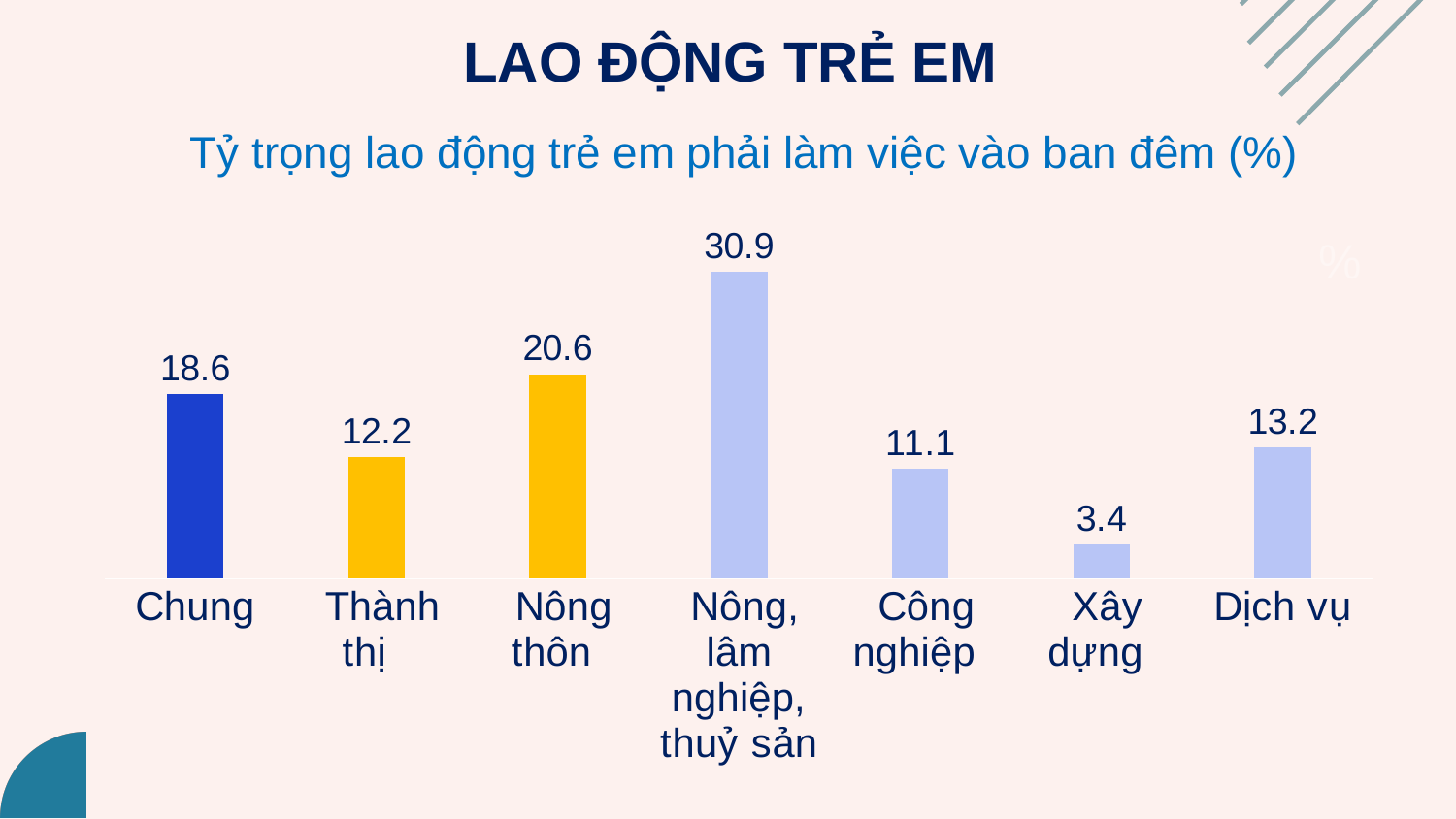
What is the value for Xây dựng? 3.4 What kind of chart is shown on the slide? Bar chart What is the value for Nông, lâm nghiệp, thuỷ sản? 30.9 What is the value for Chung? 18.6 What is the subtitle of the chart? Tỷ trọng lao động trẻ em phải làm việc vào ban đêm (%) Which category has the lowest value? Xây dựng What is the difference between the values for Dịch vụ and Công nghiệp? 2.1 Which is larger, the value for Chung or the value for Nông thôn? Nông thôn What is the value for Dịch vụ? 13.2 How many categories are shown in the chart? 7 What is the difference between the values for Nông thôn and Thành thị? 8.4 Which category has the highest value? Nông, lâm nghiệp, thuỷ sản